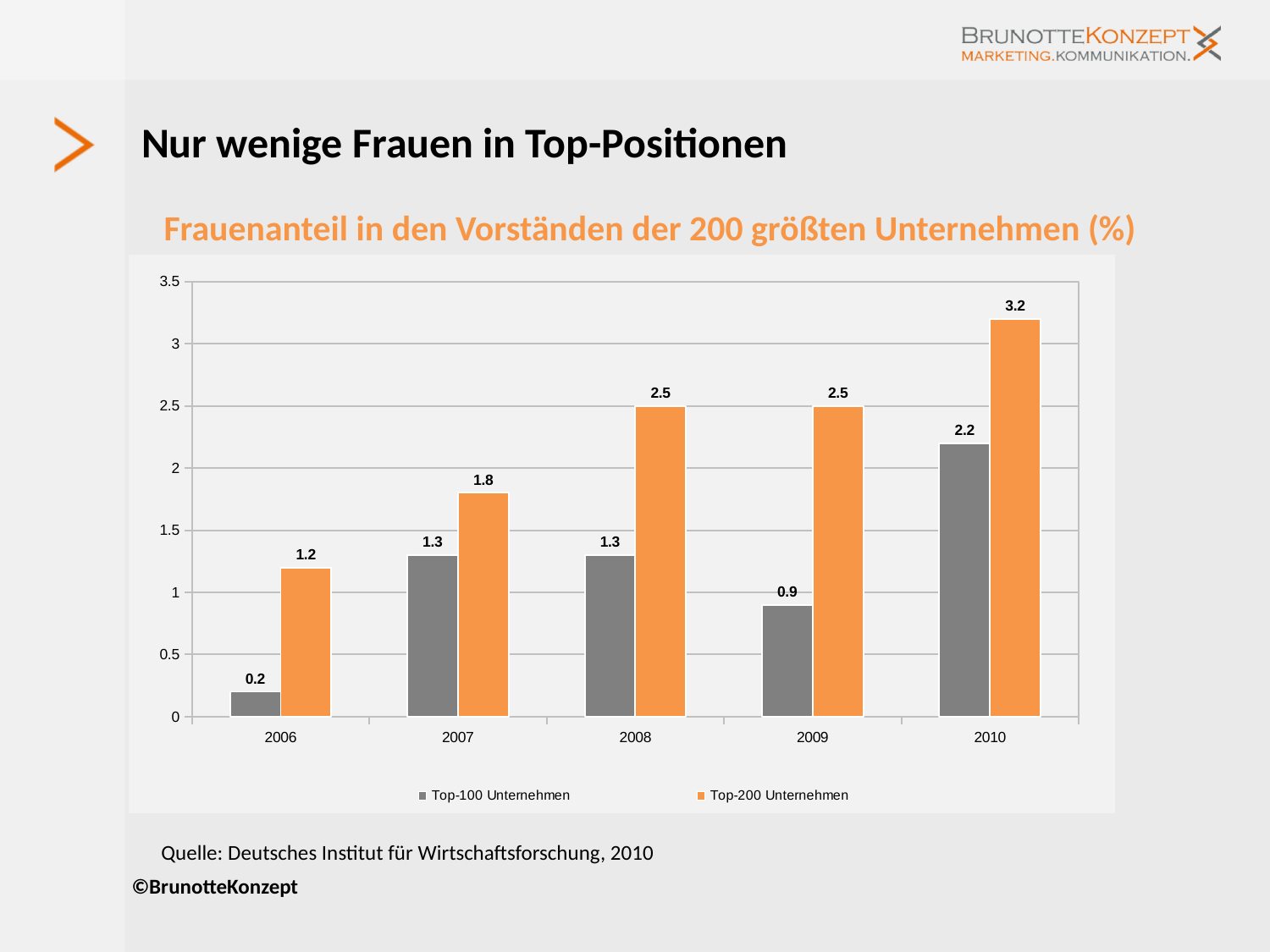
What is the value for Top-100 Unternehmen in 2009? 0.9 What is the value for Top-100 Unternehmen in 2006? 0.2 Which is larger in 2007: Top-100 Unternehmen or Top-200 Unternehmen? Top-200 Unternehmen How many years are shown on the x axis? 5 What is the difference between Top-200 Unternehmen and Top-100 Unternehmen in 2009? 1.6 What is the title of the chart? Frauenanteil in den Vorständen der 200 größten Unternehmen (%) Do the values for Top-200 Unternehmen rise or fall from 2006 to 2010? Rise What is the value for Top-200 Unternehmen in 2010? 3.2 How many series does the legend list? 2 Which year has the lowest value for Top-100 Unternehmen? 2006 Which year has the highest value for Top-200 Unternehmen? 2010 What kind of chart is shown on the slide? Bar chart